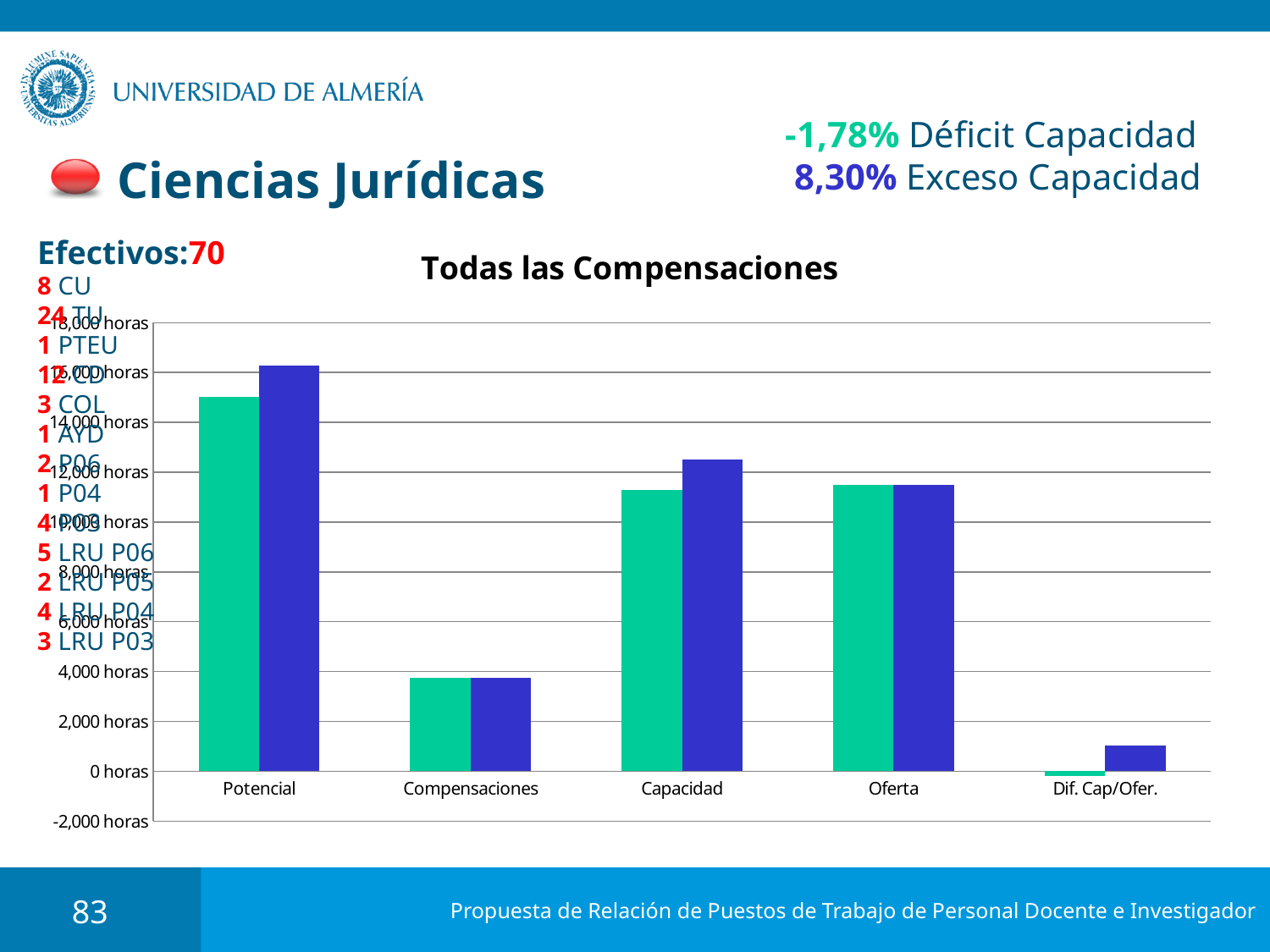
Is the value of the green bar for Oferta greater or less than 10,000 horas? greater Which category has the tallest bars in the chart? Potencial What kind of chart is shown on the slide? bar chart Is the value of the green bar for Compensaciones greater or less than 4,000 horas? less What is the title of the chart? Todas las Compensaciones How many categories are shown on the x axis of the chart? 5 Is the value of the green bar for Potencial greater or less than 14,000 horas? greater Which category has the lowest bars in the chart? Dif. Cap/Ofer. Which is larger, the green bar for Potencial or the green bar for Capacidad? Potencial